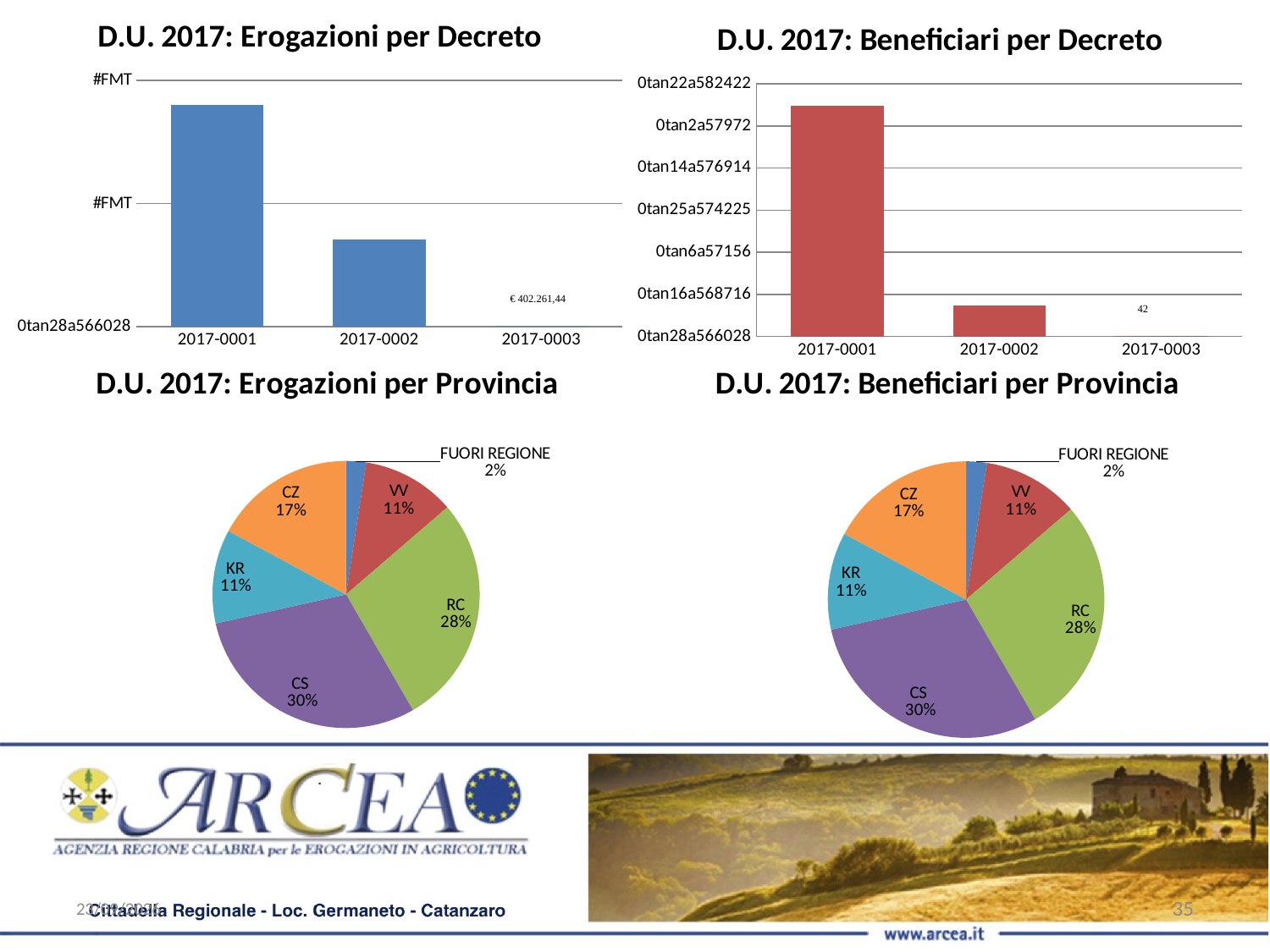
In the chart titled "D.U. 2017: Beneficiari per Provincia", what share does RC have? 28% In the chart titled "D.U. 2017: Erogazioni per Decreto", what value is labelled for 2017-0003? € 402.261,44 In the chart titled "D.U. 2017: Erogazioni per Decreto", how many decrees are shown on the x axis? 3 In the chart titled "D.U. 2017: Erogazioni per Provincia", which province has the largest slice? CS In the chart titled "D.U. 2017: Erogazioni per Provincia", how many slices does the pie have? 6 In the chart titled "D.U. 2017: Beneficiari per Provincia", what is the difference between the shares of CZ and FUORI REGIONE? 15% In the chart titled "D.U. 2017: Beneficiari per Decreto", which decree has the lowest value? 2017-0003 In the chart titled "D.U. 2017: Beneficiari per Decreto", is the value for 2017-0001 larger or smaller than the value for 2017-0002? larger In the chart titled "D.U. 2017: Erogazioni per Provincia", what share does CS have? 30% In the chart titled "D.U. 2017: Erogazioni per Decreto", which decree has the highest value? 2017-0001 In the chart titled "D.U. 2017: Beneficiari per Decreto", what value is labelled for 2017-0003? 42 In the chart titled "D.U. 2017: Erogazioni per Decreto", what kind of chart is shown? bar chart